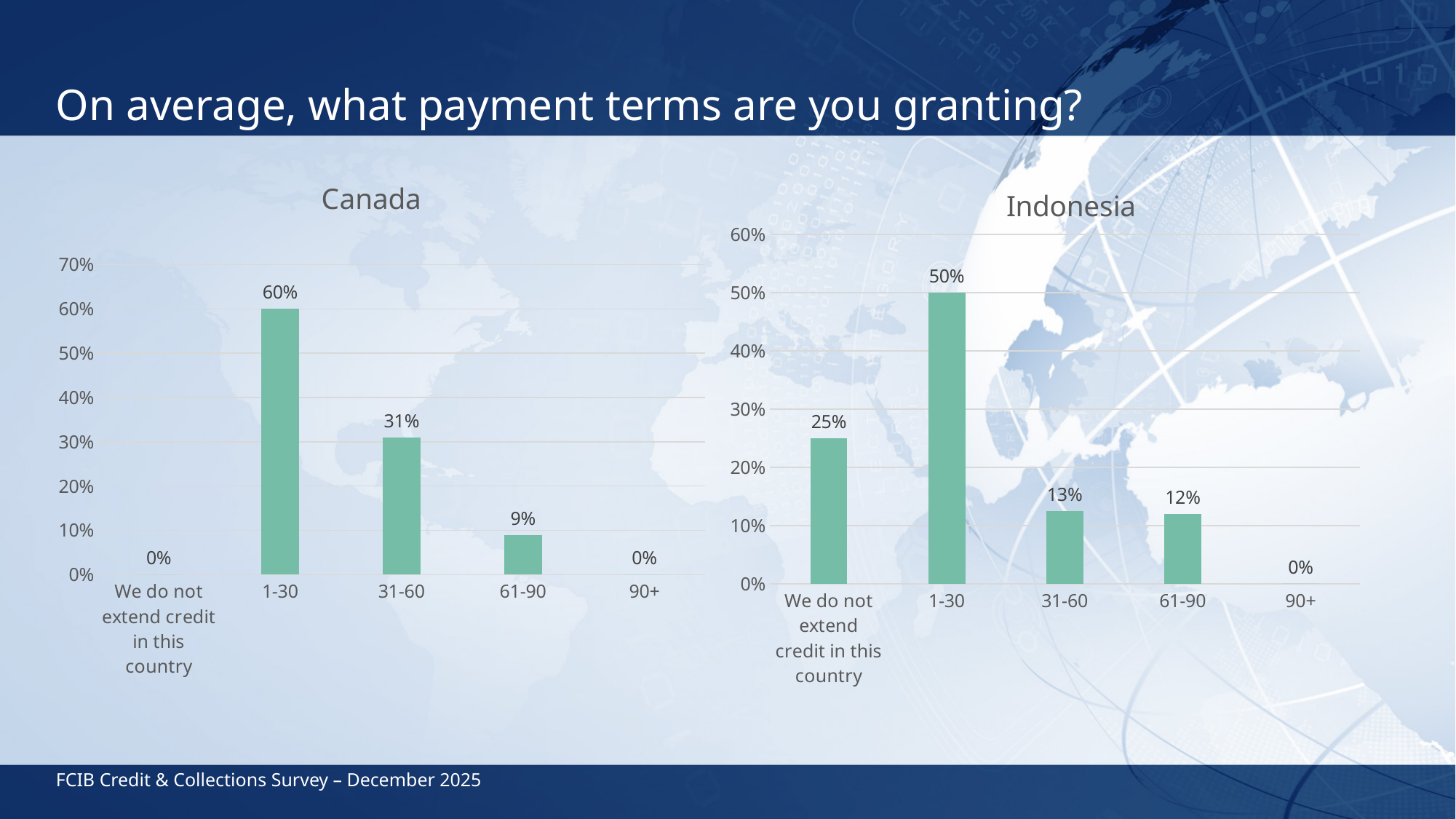
In the Indonesia chart, which category has the highest value? 1-30 In the Canada chart, what is the value for 61-90? 9% In the Indonesia chart, what is the value for 90+? 0% Which is larger: the value for 31-60 in the Canada chart or the value for 31-60 in the Indonesia chart? Canada What kind of chart is the Indonesia chart? bar chart How many categories are shown in the Canada chart? 5 In the Canada chart, what is the value for 1-30? 60% In the Indonesia chart, what is the difference between the values for 1-30 and 31-60? 37% In the Canada chart, what is the difference between the values for 1-30 and 31-60? 29% In the Indonesia chart, is the value for 1-30 greater or less than 40%? greater In the Canada chart, which category has the highest value? 1-30 In the Indonesia chart, what is the value for 'We do not extend credit in this country'? 25%